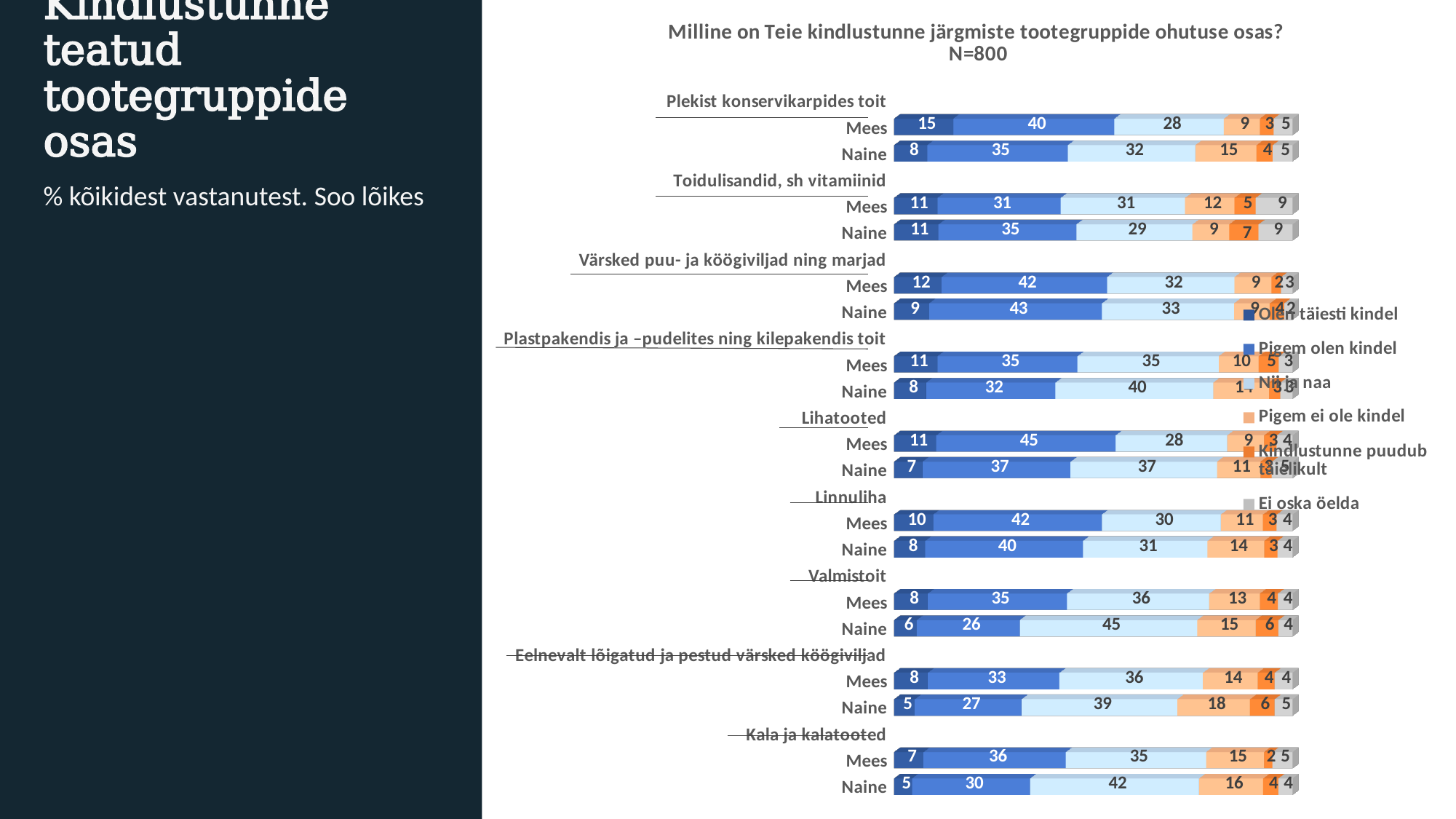
How many series does the legend list? 6 What kind of chart is shown on the slide? Stacked bar chart What is the difference between the 'Pigem olen kindel' values for men and women for Kala ja kalatooted? 6 What percentage of men (Mees) answered 'Olen täiesti kindel' for Plekist konservikarpides toit? 15 What percentage of women (Naine) answered 'Nii ja naa' for Valmistoit? 45 How many product groups are shown in the chart? 9 What is the total of the stacked bar for Plekist konservikarpides toit, Mees? 100 What percentage of women (Naine) answered 'Pigem ei ole kindel' for Eelnevalt lõigatud ja pestud värsked köögiviljad? 18 Which bar has the highest 'Olen täiesti kindel' value? Plekist konservikarpides toit, Mees Which bar has the lowest 'Pigem olen kindel' value? Valmistoit, Naine For Linnuliha, who has the higher 'Pigem ei ole kindel' value, Mees or Naine? Naine What percentage of men (Mees) answered 'Pigem olen kindel' for Lihatooted? 45